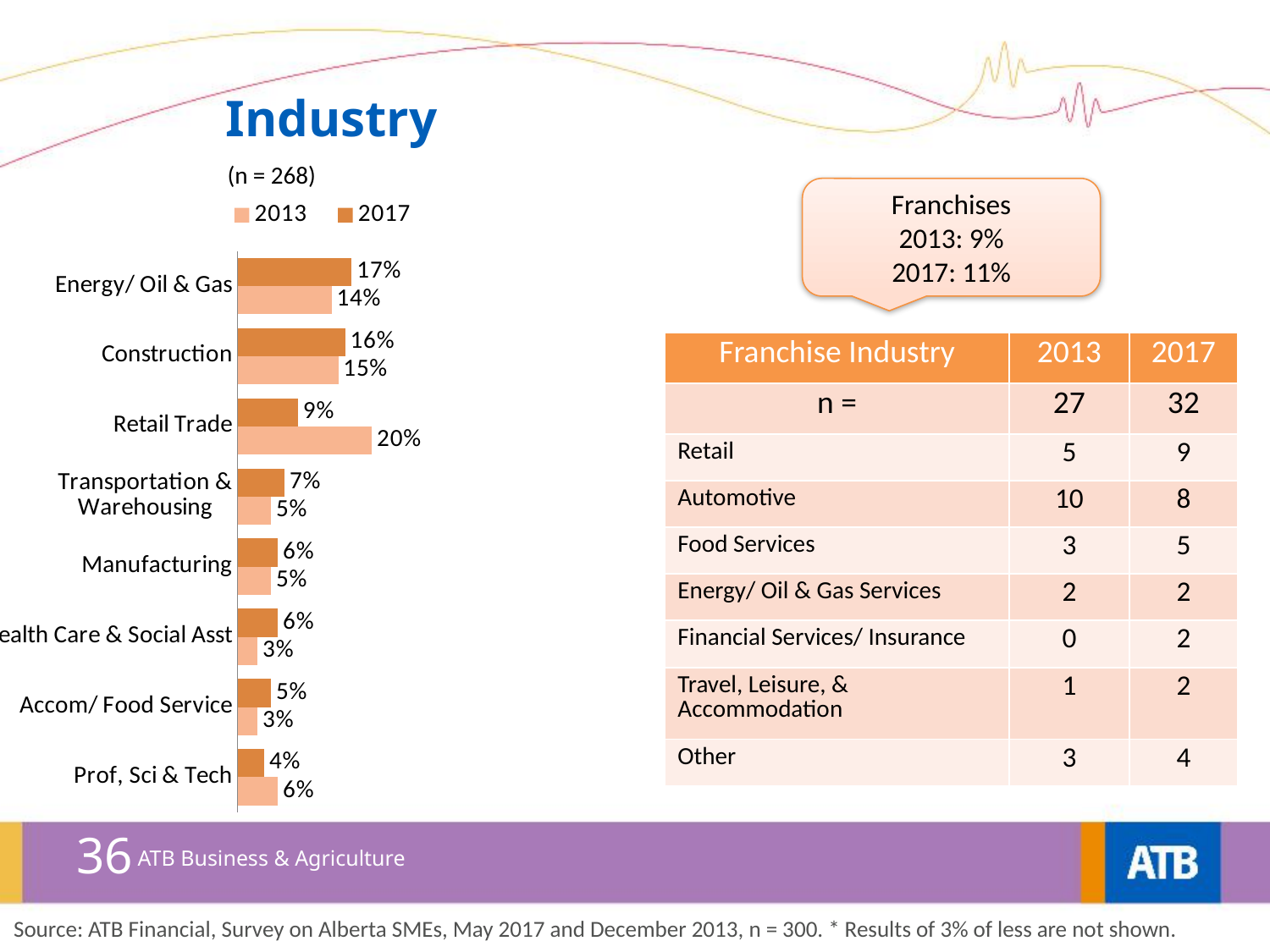
What is the 2017 value for Energy/ Oil & Gas? 17% Which industry has the lowest 2017 value? Prof, Sci & Tech What is the difference between the 2013 and 2017 values for Retail Trade? 11 percentage points Which industry has the highest 2013 value? Retail Trade What is the 2013 value for Retail Trade? 20% What type of chart is shown on the slide? Bar chart What sample size (n) is shown above the chart? n = 268 Which industry has the highest 2017 value? Energy/ Oil & Gas How many industry categories are shown in the chart? 8 For Construction, which year has the larger value, 2013 or 2017? 2017 What is the 2013 value for Manufacturing? 5% How many series does the chart legend list? 2